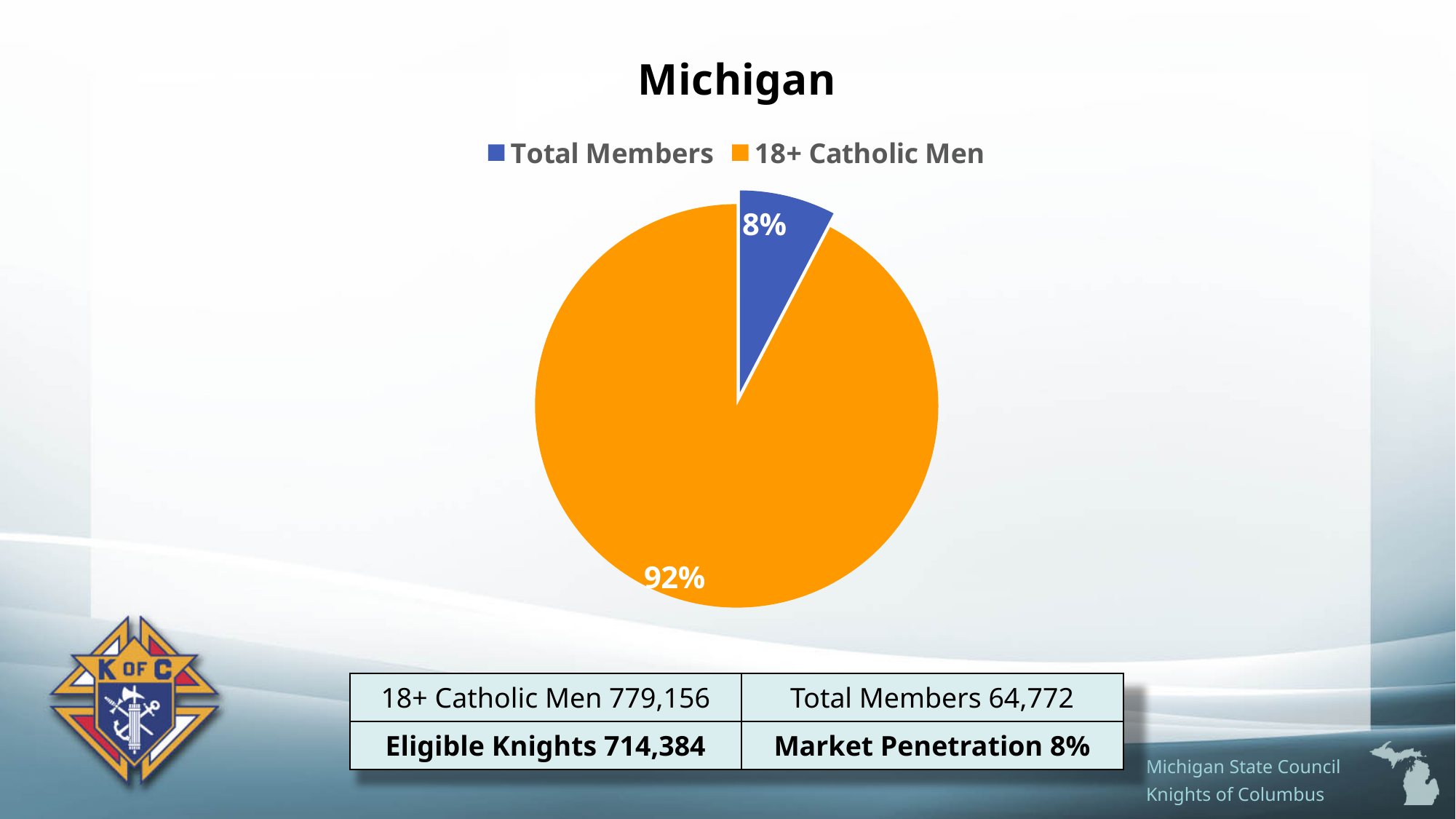
Which is larger, the Total Members slice or the 18+ Catholic Men slice? 18+ Catholic Men Which slice is the largest in the pie chart? 18+ Catholic Men What colour is the 18+ Catholic Men slice? Orange Which slice is the smallest in the pie chart? Total Members What share of the pie does the 18+ Catholic Men slice represent? 92% What kind of chart is shown on the slide? Pie chart What is the difference in percentage points between the 18+ Catholic Men slice and the Total Members slice? 84 What is the title of the chart? Michigan What share of the pie does the Total Members slice represent? 8% How many series does the legend list? 2 How many slices does the pie chart have? 2 Is the share for Total Members greater or less than 10%? less